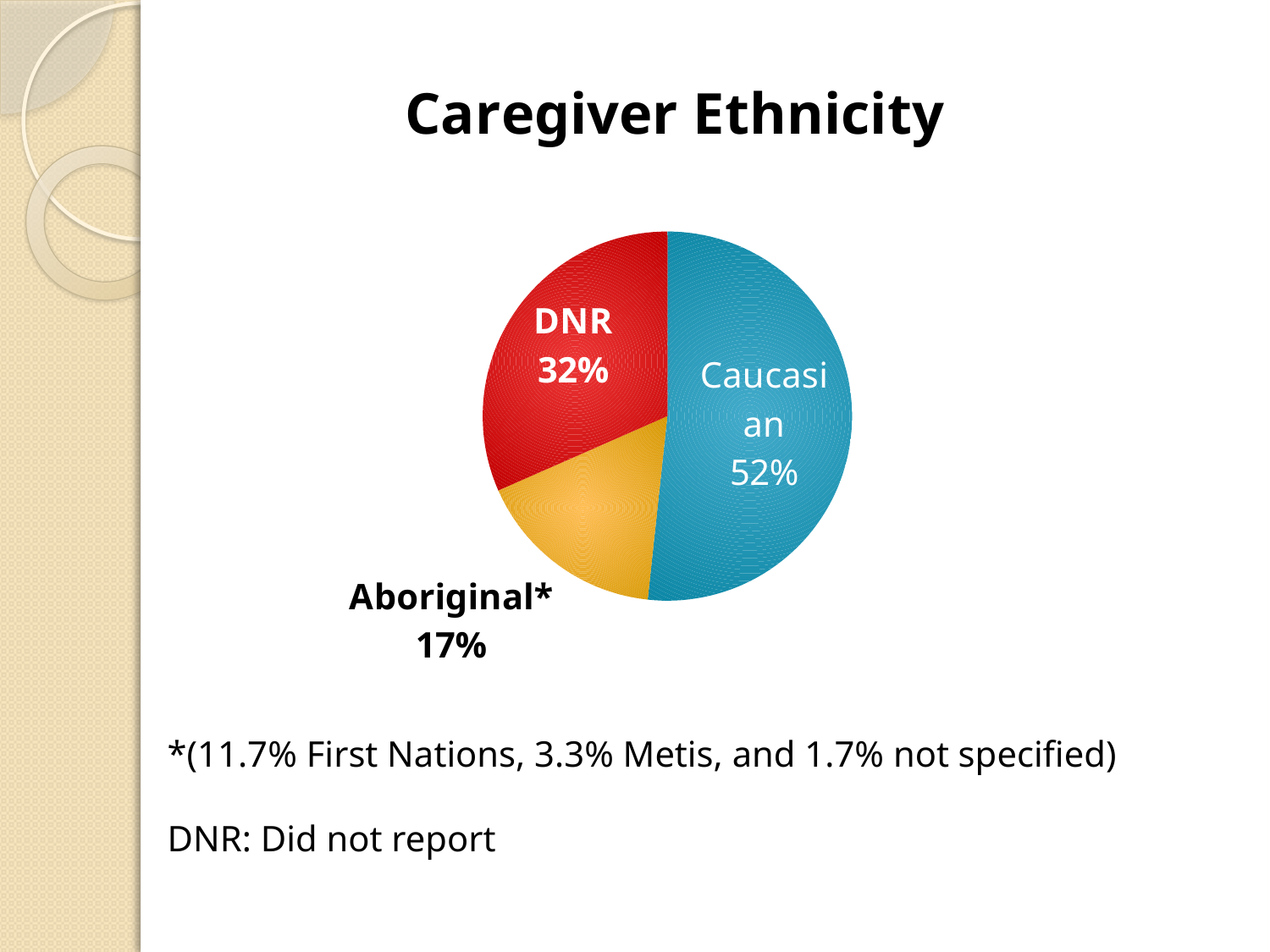
What is the difference in percentage points between the Caucasian and DNR slices? 20 Which is larger, the DNR slice or the Aboriginal* slice? DNR Which category has the smallest share of the pie? Aboriginal* How many slices does the pie chart have? 3 What is the title of the chart? Caregiver Ethnicity What is the difference in percentage points between the DNR and Aboriginal* slices? 15 What percentage of caregivers are Aboriginal*? 17% What colour is the Caucasian slice? Blue What percentage of caregivers are Caucasian? 52% What kind of chart is shown on the slide? Pie chart What percentage of caregivers are in the DNR category? 32% Which category has the largest share of the pie? Caucasian